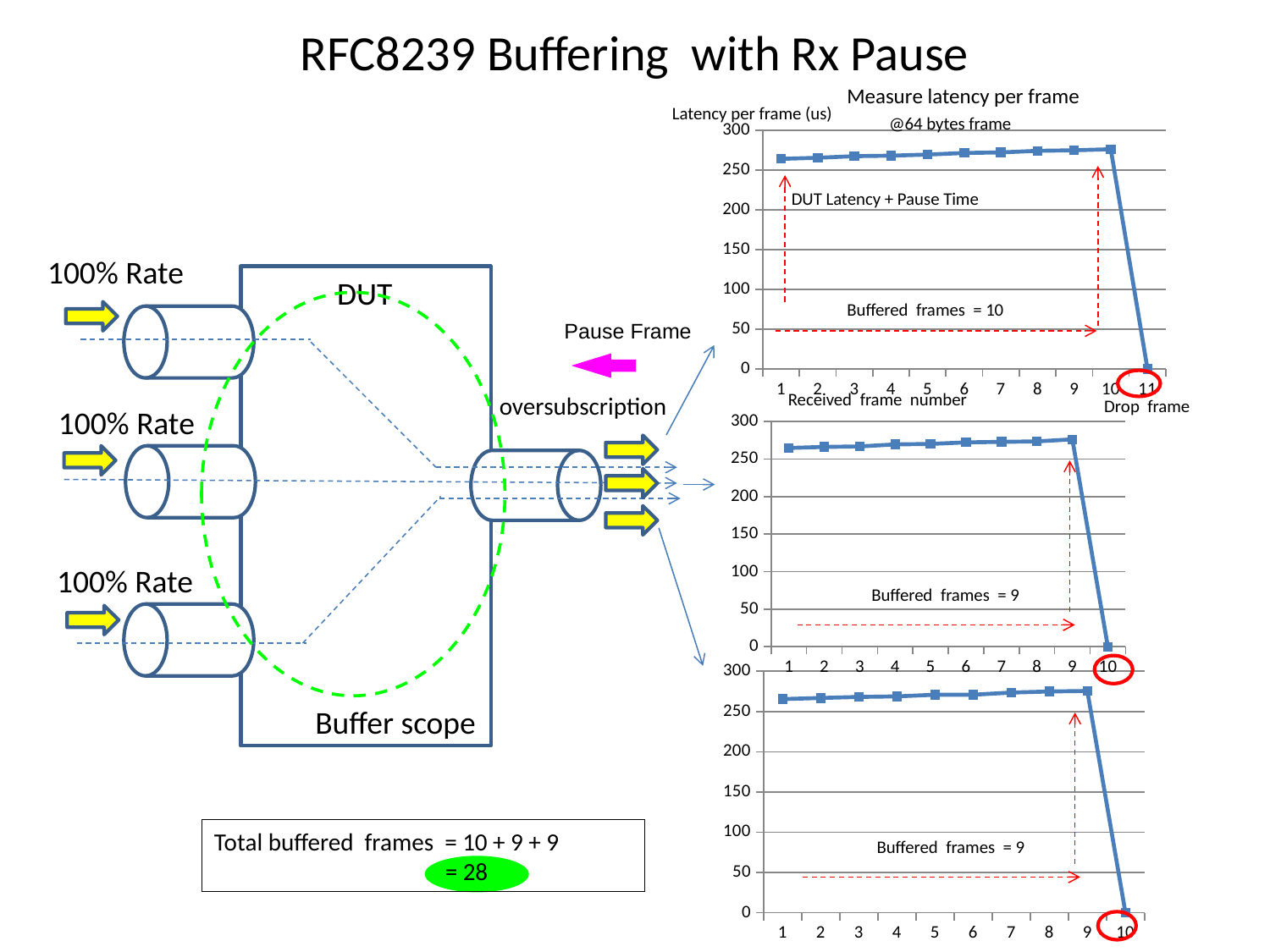
In the middle chart on the right, how many frame numbers are plotted on the x axis? 10 What kind of chart is the top chart titled 'Measure latency per frame'? line chart In the middle chart on the right, is the value for frame number 3 greater or less than 200? greater In the bottom chart on the right, which frame number has the lowest value? 10 According to the annotation on the top chart 'Measure latency per frame', how many buffered frames are there? 10 In the top chart 'Measure latency per frame', how many received frame numbers are plotted on the x axis? 11 In the top chart 'Measure latency per frame', is the value for received frame number 5 greater or less than 250? greater In the top chart 'Measure latency per frame', which received frame number has the lowest latency? 11 In the top chart 'Measure latency per frame', which has the larger latency: received frame number 1 or received frame number 11? received frame number 1 In the top chart 'Measure latency per frame', what is the latency value plotted for received frame number 11? 0 In the bottom chart on the right, what is the value plotted for frame number 10? 0 What is the y-axis label of the top chart 'Measure latency per frame'? Latency per frame (us)